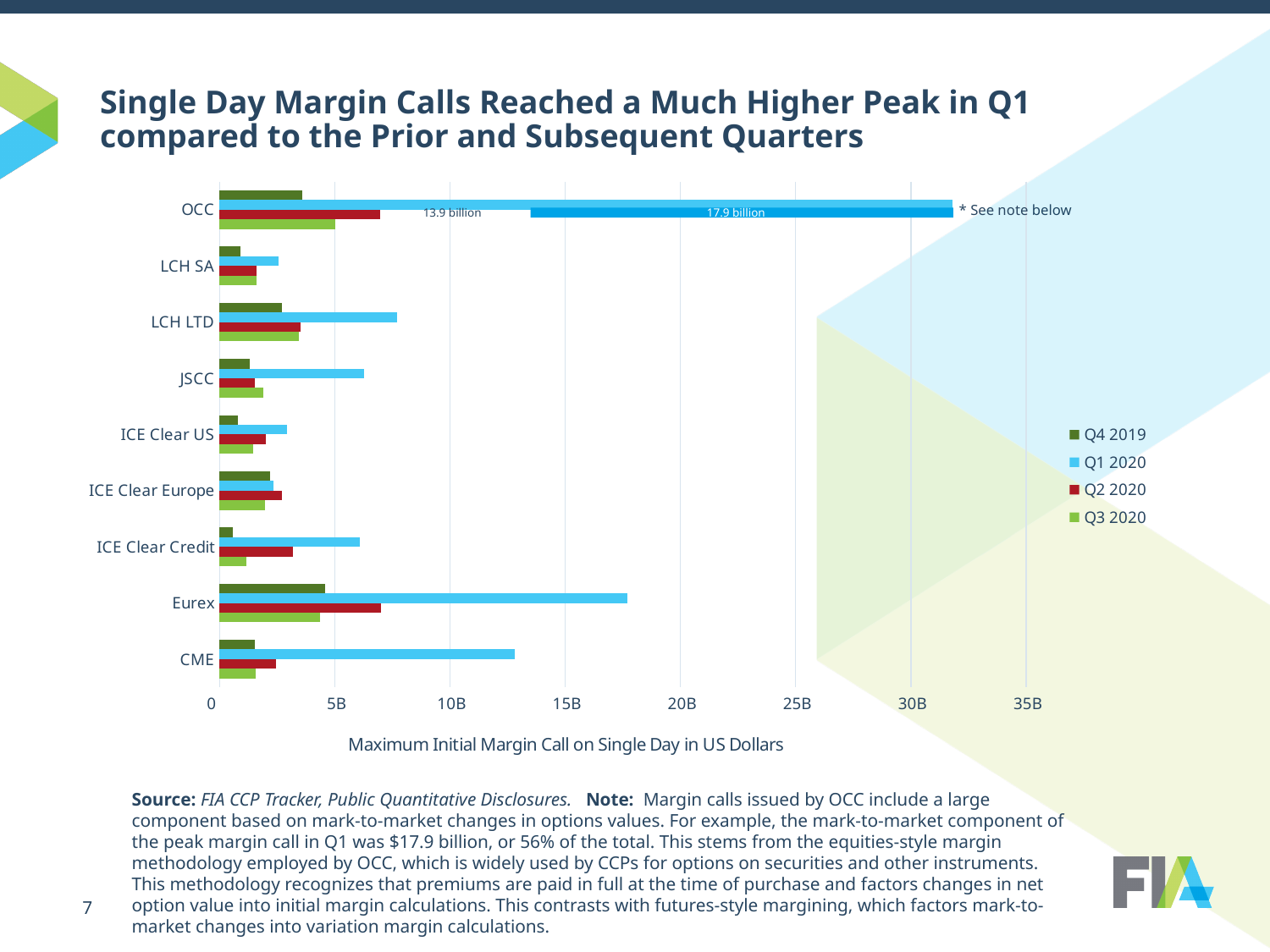
For LCH LTD, which is larger, the Q1 2020 value or the Q2 2020 value? Q1 2020 What two values are labeled on the OCC Q1 2020 bar? 13.9 billion and 17.9 billion Is the Q1 2020 value for JSCC greater or less than 5B? greater How many clearing houses (categories) are shown on the chart? 9 Is the Q1 2020 value for CME greater or less than 10B? greater How many series does the legend list? 4 What is the title of the horizontal axis? Maximum Initial Margin Call on Single Day in US Dollars Is the Q1 2020 value for Eurex greater or less than 15B? greater Which clearing house has the highest Q1 2020 value? OCC Which is larger, the Q1 2020 value for Eurex or the Q1 2020 value for CME? Eurex What type of chart is shown on the slide? Bar chart Which series is shown in light blue in the legend? Q1 2020